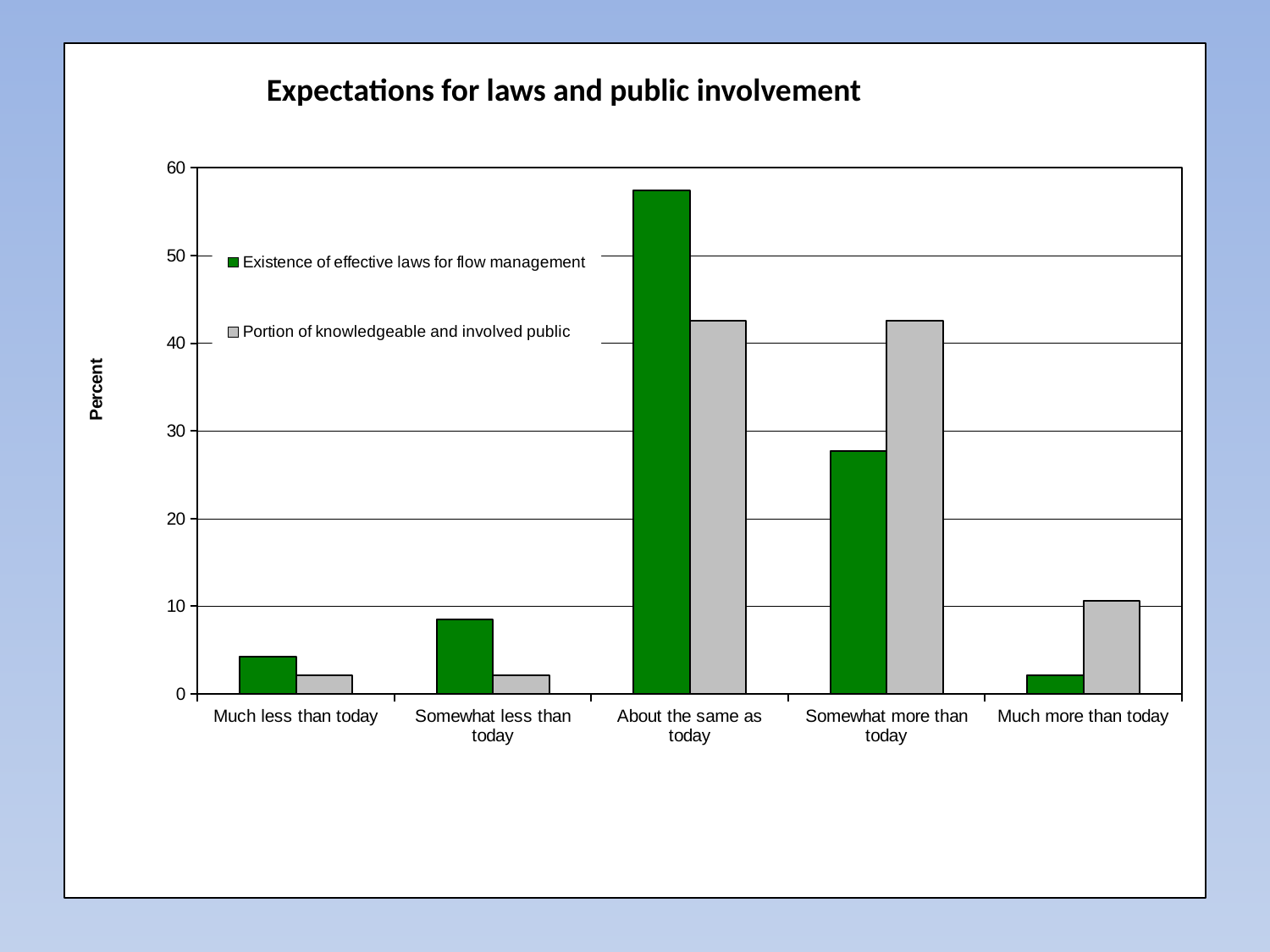
What kind of chart is shown on the slide? bar chart How many series does the legend list? 2 Is the value for Portion of knowledgeable and involved public in the About the same as today category greater or less than 40? greater In the About the same as today category, which series has the larger value? Existence of effective laws for flow management Is the value for Existence of effective laws for flow management in the Somewhat more than today category greater or less than 30? less Is the value for Existence of effective laws for flow management in the About the same as today category greater or less than 50? greater Which category has the lowest value for Existence of effective laws for flow management? Much more than today How many categories are shown on the x axis? 5 What is the title of the chart? Expectations for laws and public involvement What is the label of the y axis? Percent Which category has the highest value for Existence of effective laws for flow management? About the same as today In the Somewhat more than today category, which series has the larger value? Portion of knowledgeable and involved public